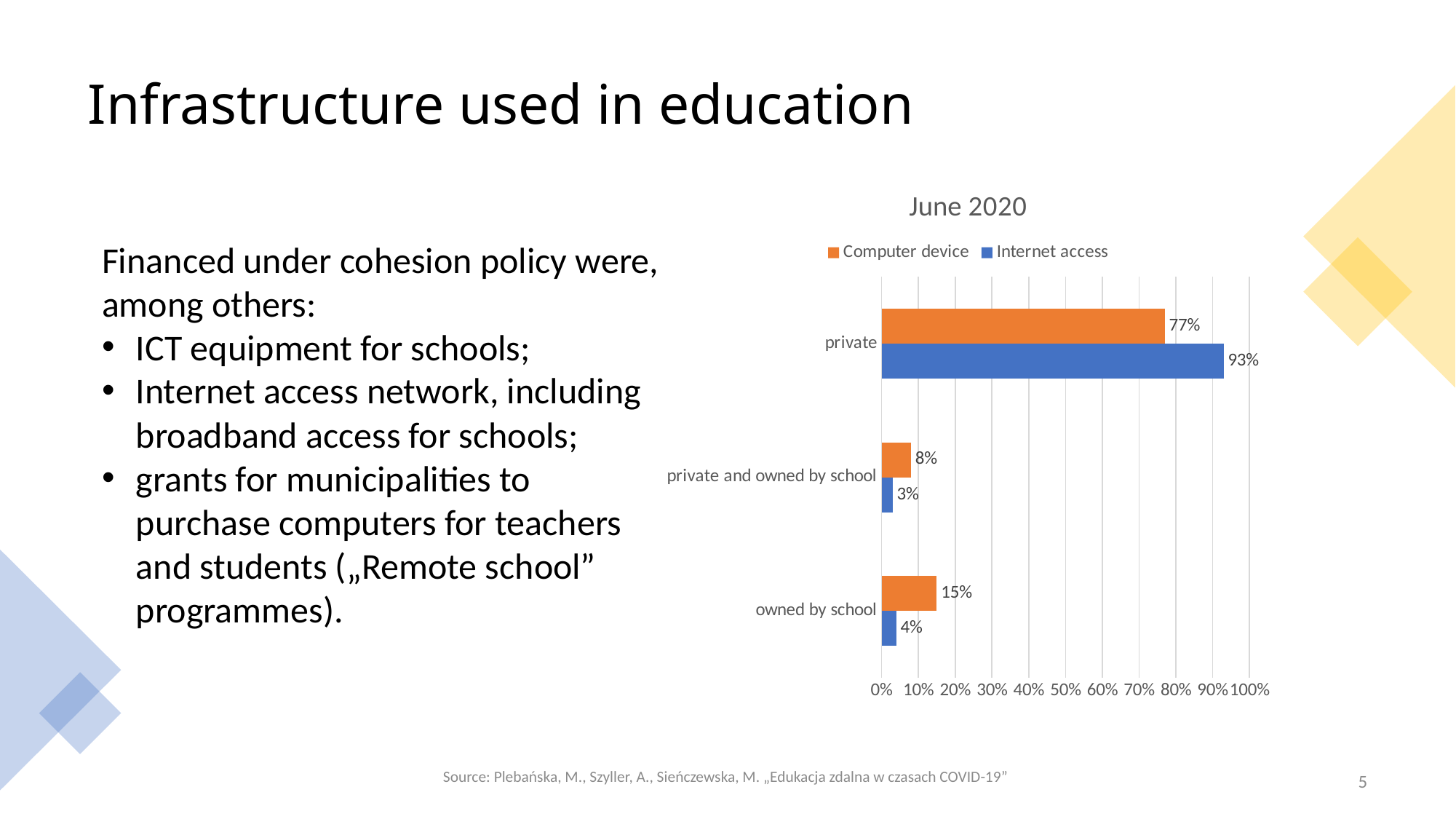
What is the Internet access value for the private and owned by school category? 3% Which category has the highest Computer device value? private What kind of chart is shown on the slide? bar chart What is the Computer device value for the private category? 77% How many categories are shown on the chart? 3 What is the difference between the Internet access and Computer device values for the private category? 16% Which is larger for the owned by school category: Computer device or Internet access? Computer device What is the Internet access value for the private category? 93% How many series does the legend list? 2 Which category has the lowest Internet access value? private and owned by school What is the Computer device value for the owned by school category? 15% What is the title of the chart? June 2020